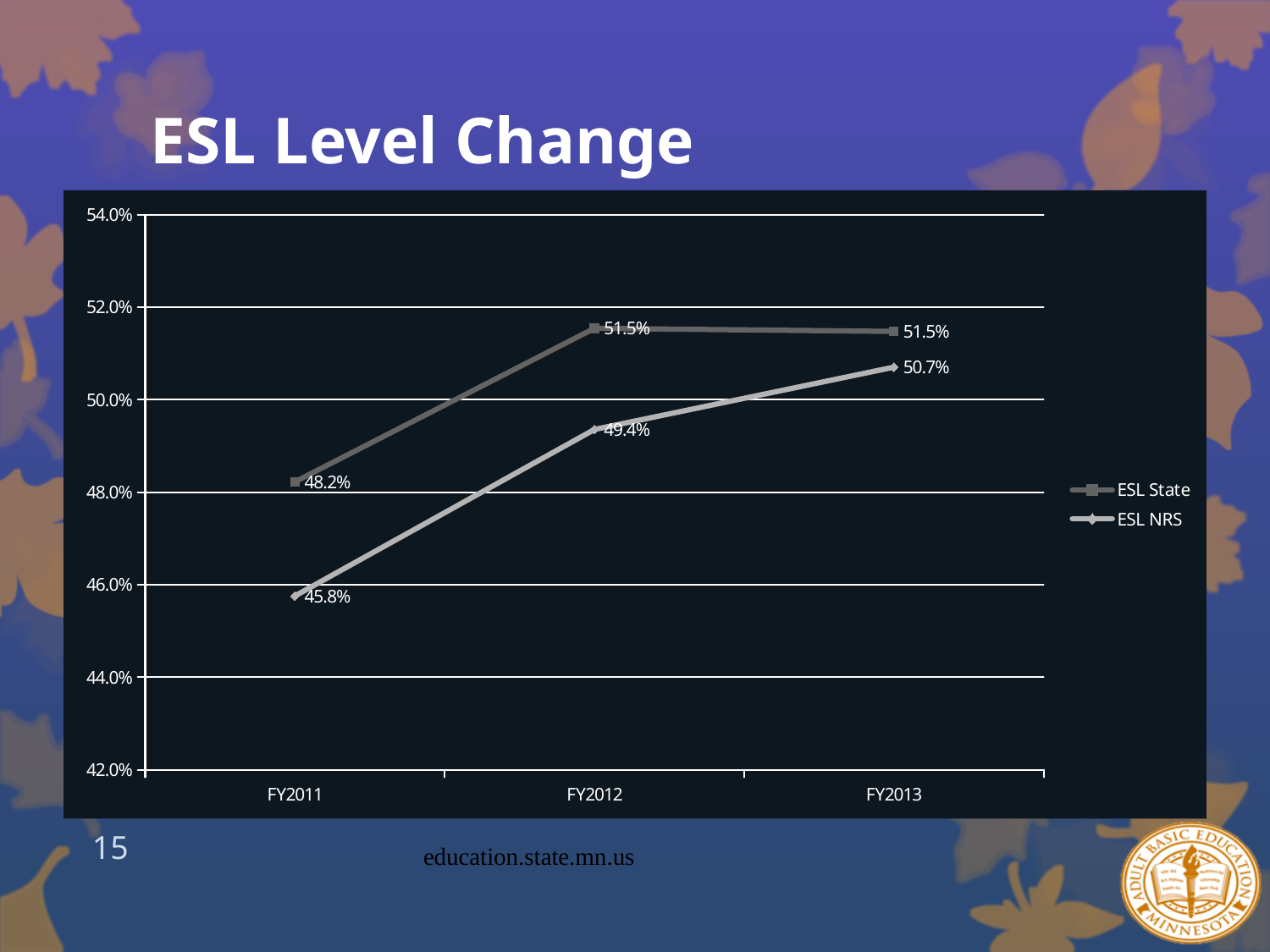
What is the value for ESL State in FY2011? 48.2% In which fiscal year is the ESL NRS value lowest? FY2011 What kind of chart is shown on the slide? line chart Is the value for ESL NRS in FY2011 greater or less than 46.0%? less How many fiscal years are shown on the x axis? 3 Does the ESL NRS series rise or fall from FY2011 to FY2013? rise What is the difference between ESL State and ESL NRS in FY2011? 2.4% What is the difference between ESL State and ESL NRS in FY2013? 0.8% What is the value for ESL NRS in FY2012? 49.4% Which series has the larger value in FY2012, ESL State or ESL NRS? ESL State What is the value for ESL NRS in FY2013? 50.7% How many series does the legend list? 2